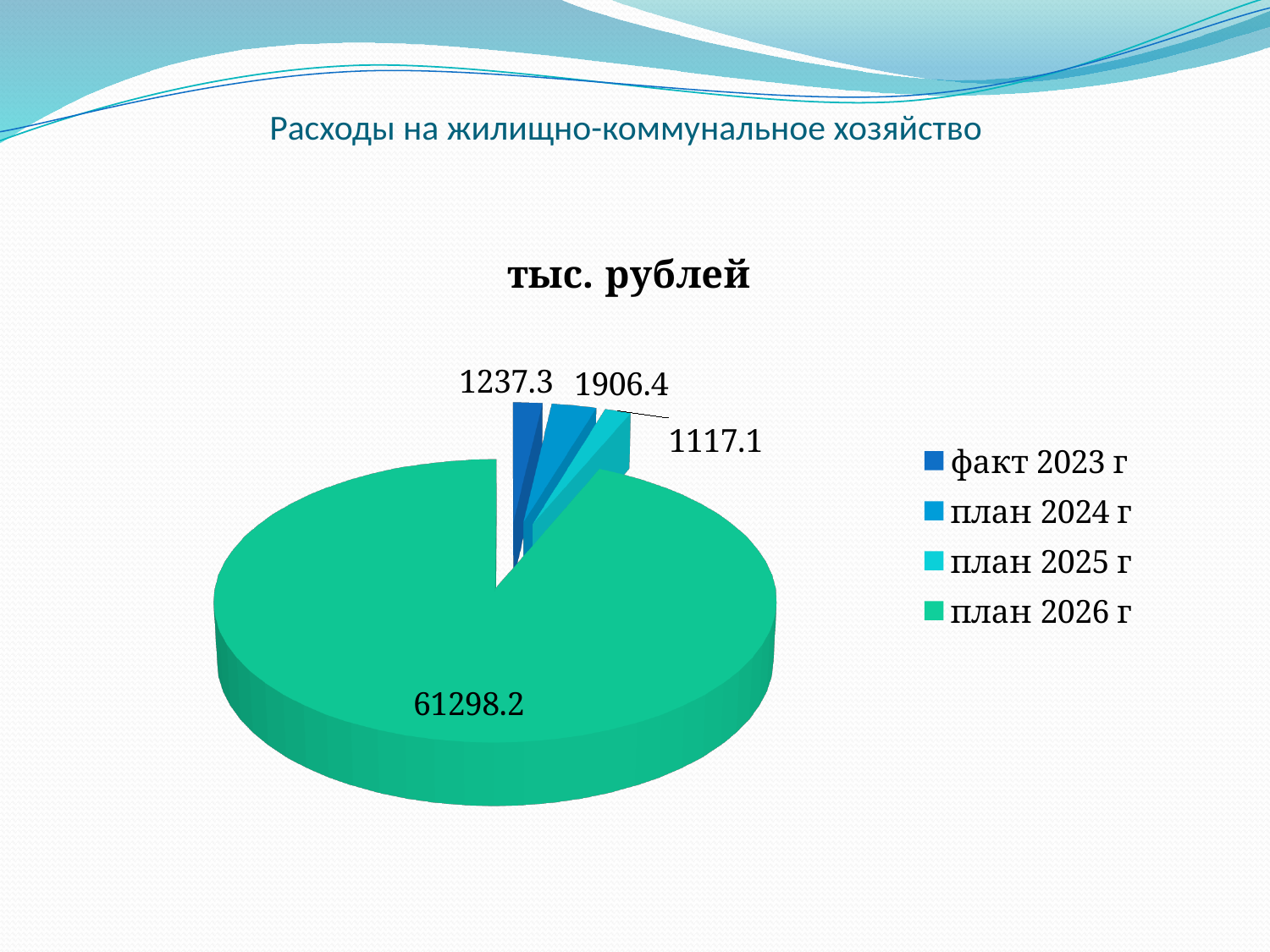
What is the value for план 2026 г? 61298.2 Which is larger, the value for план 2024 г or the value for план 2025 г? план 2024 г What is the difference between the values for план 2024 г and факт 2023 г? 669.1 What is the value for план 2025 г? 1117.1 How many categories does the legend list? 4 What is the value for план 2024 г? 1906.4 What is the value for факт 2023 г? 1237.3 What kind of chart is shown on the slide? pie chart What is the title of the chart? тыс. рублей What is the difference between the values for факт 2023 г and план 2025 г? 120.2 Which category has the largest slice? план 2026 г Which category has the smallest value? план 2025 г